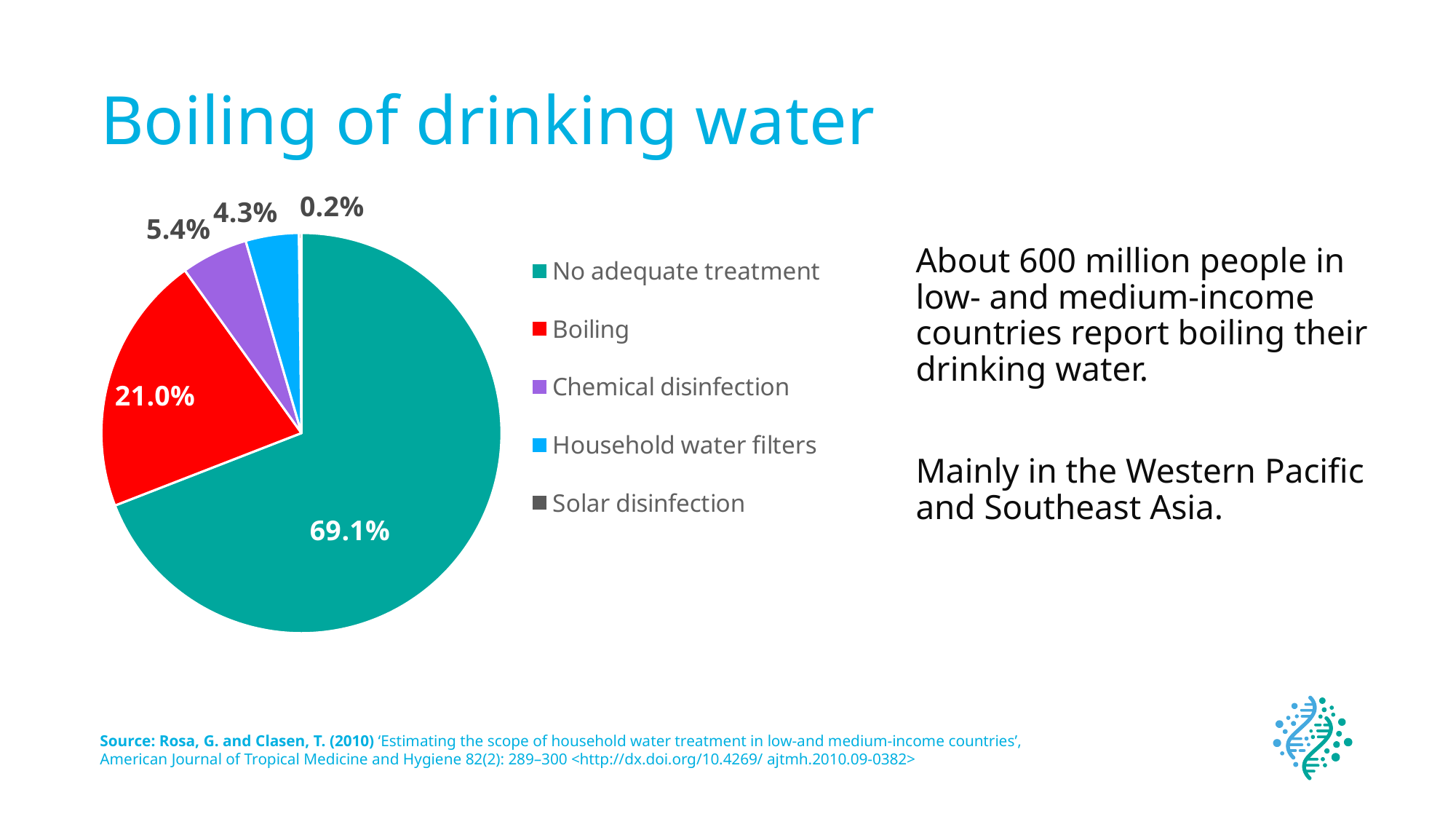
What colour is the slice for Boiling? red Which category has the largest slice of the pie? No adequate treatment What share of the pie is labelled for Boiling? 21.0% What is the difference in percentage points between No adequate treatment and Boiling? 48.1 Which is larger, the slice for Chemical disinfection or the slice for Household water filters? Chemical disinfection What share of the pie is labelled for Solar disinfection? 0.2% What share of the pie is labelled for Chemical disinfection? 5.4% What share of the pie is labelled for No adequate treatment? 69.1% What kind of chart is shown on the slide? pie chart What share of the pie is labelled for Household water filters? 4.3% How many categories does the pie chart show? 5 Which category has the smallest slice of the pie? Solar disinfection